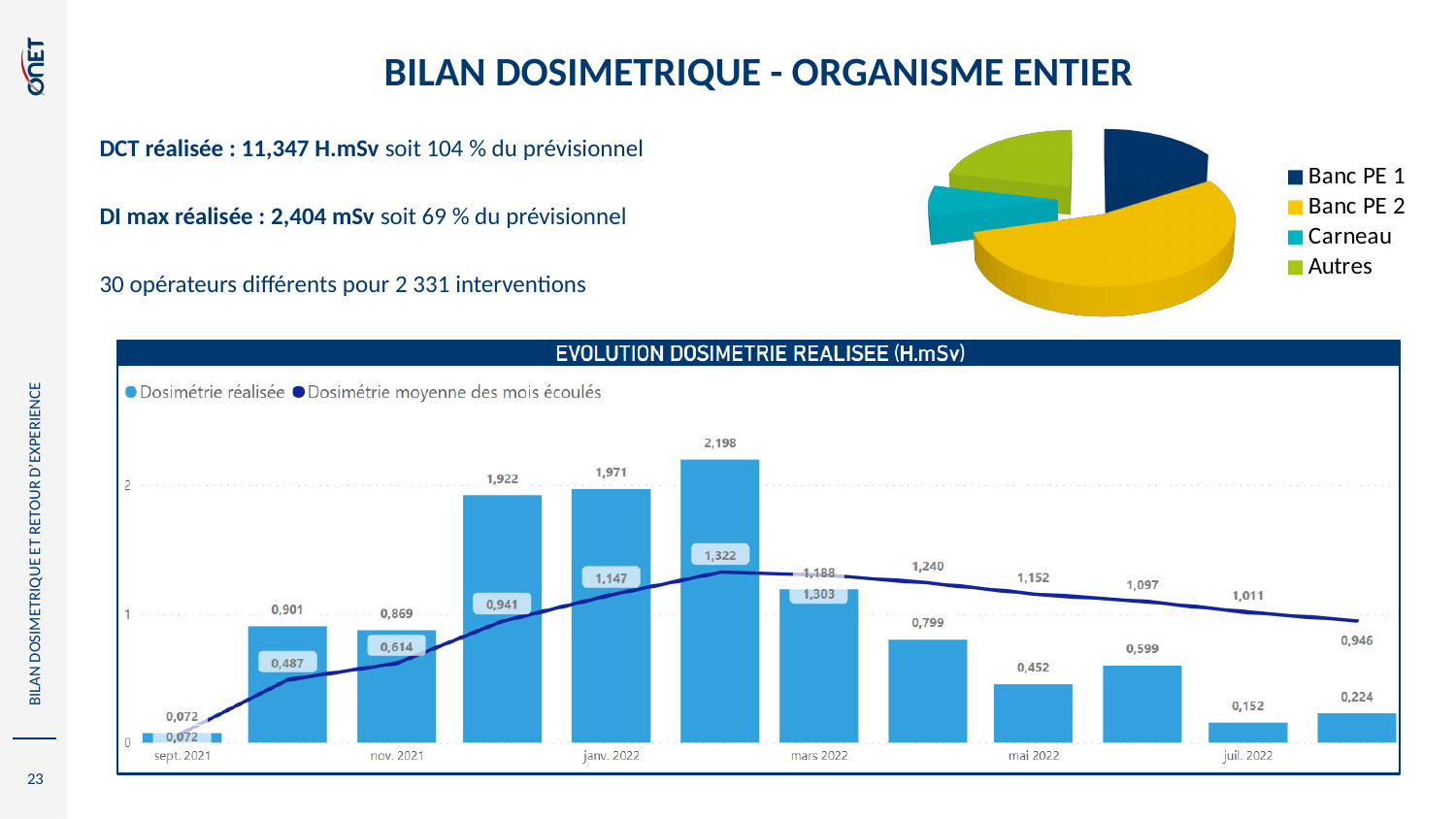
In the EVOLUTION DOSIMETRIE REALISEE chart, is the Dosimétrie réalisée value for juil. 2022 greater or less than 1? less In the EVOLUTION DOSIMETRIE REALISEE chart, for mai 2022, which is larger: Dosimétrie réalisée or Dosimétrie moyenne des mois écoulés? Dosimétrie moyenne des mois écoulés In the EVOLUTION DOSIMETRIE REALISEE chart, which month has the lowest Dosimétrie réalisée value? sept. 2021 In the EVOLUTION DOSIMETRIE REALISEE chart, what is the highest Dosimétrie réalisée value shown? 2,198 In the EVOLUTION DOSIMETRIE REALISEE chart, what is the difference between the Dosimétrie réalisée values for janv. 2022 and nov. 2021? 1,102 In the EVOLUTION DOSIMETRIE REALISEE chart, how many series does the legend list? 2 In the pie chart at the top right, which category has the largest slice? Banc PE 2 In the EVOLUTION DOSIMETRIE REALISEE chart, what is the Dosimétrie réalisée value for janv. 2022? 1,971 In the EVOLUTION DOSIMETRIE REALISEE chart, what is the Dosimétrie moyenne des mois écoulés value for mars 2022? 1,188 What kind of chart is shown at the top right of the slide? Pie chart In the EVOLUTION DOSIMETRIE REALISEE chart, what is the Dosimétrie réalisée value for mai 2022? 0,452 In the EVOLUTION DOSIMETRIE REALISEE chart, how many bars are plotted? 12